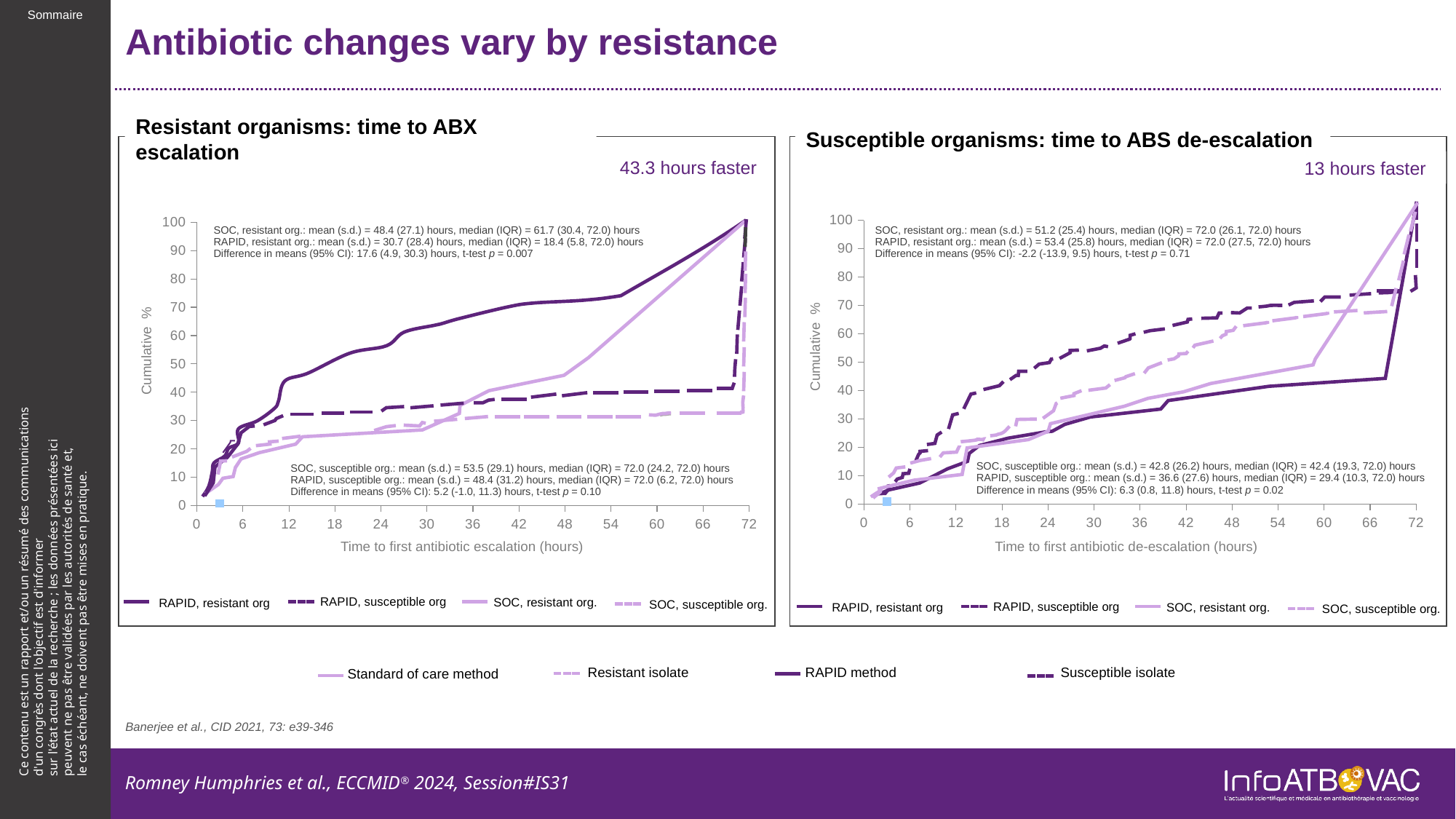
In the 'Susceptible organisms: time to ABS de-escalation' chart, at 24 hours which series has the higher cumulative %: 'RAPID, susceptible org' or 'RAPID, resistant org'? RAPID, susceptible org In the 'Resistant organisms: time to ABX escalation' chart, is the cumulative % for 'RAPID, resistant org' at 24 hours greater or less than 50? greater In the 'Resistant organisms: time to ABX escalation' chart, do the curves rise or fall as time increases along the x axis? rise How many series does the legend of the 'Susceptible organisms: time to ABS de-escalation' chart list? 4 In the 'Susceptible organisms: time to ABS de-escalation' chart, is the cumulative % for 'RAPID, resistant org' at 60 hours greater or less than 50? less In the 'Susceptible organisms: time to ABS de-escalation' chart, is the cumulative % for 'RAPID, susceptible org' at 36 hours greater or less than 50? greater According to the annotation on the 'Resistant organisms: time to ABX escalation' chart, how many hours faster is the RAPID method? 43.3 hours faster What is the x-axis label of the 'Susceptible organisms: time to ABS de-escalation' chart? Time to first antibiotic de-escalation (hours) What kind of chart is the 'Resistant organisms: time to ABX escalation' chart? line chart In the 'Resistant organisms: time to ABX escalation' chart, at 24 hours which series has the higher cumulative %: 'RAPID, resistant org' or 'SOC, resistant org.'? RAPID, resistant org According to the annotation on the 'Susceptible organisms: time to ABS de-escalation' chart, how many hours faster is the RAPID method? 13 hours faster